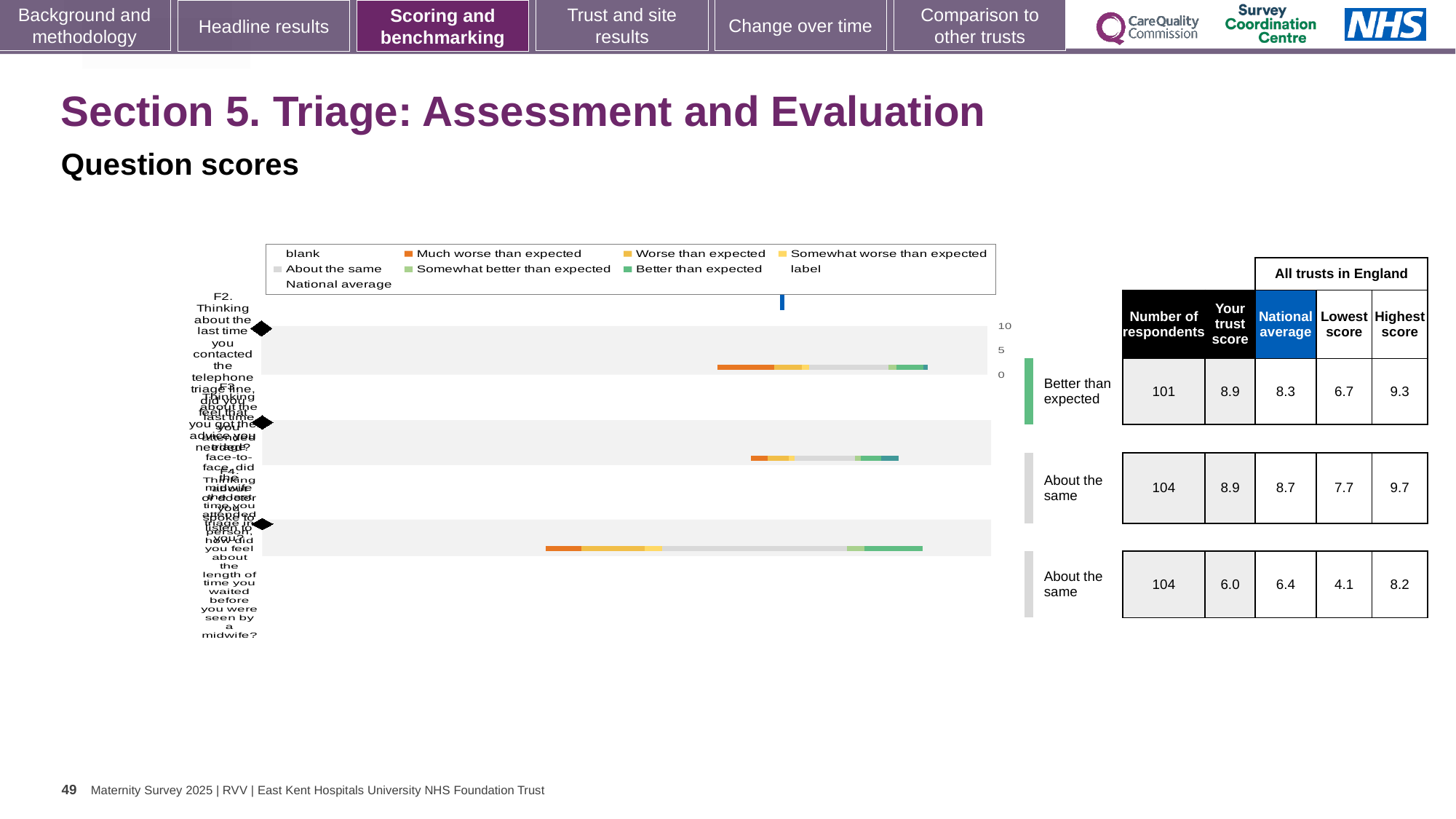
Which legend entry is shown in grey? About the same In the table beside the chart, what is the difference between the highest score and the lowest score for the third row (F4)? 4.1 How many stacked bars (questions) are plotted in the chart? 3 Which row in the table has the lowest 'Lowest score' value? third row (F4), 4.1 In the table beside the chart, how many respondents are listed for the first row (F2)? 101 What kind of chart is shown on the slide? bar chart What benchmark category is given for the first row (F2)? Better than expected Which row in the table has the highest 'Highest score' value? second row (F3), 9.7 In the table beside the chart, what is the 'Your trust score' for the first row (F2)? 8.9 For the third row (F4), which is larger: the trust score or the national average? national average In the table beside the chart, what is the national average for the third row (F4)? 6.4 Which legend entry is shown in orange? Much worse than expected